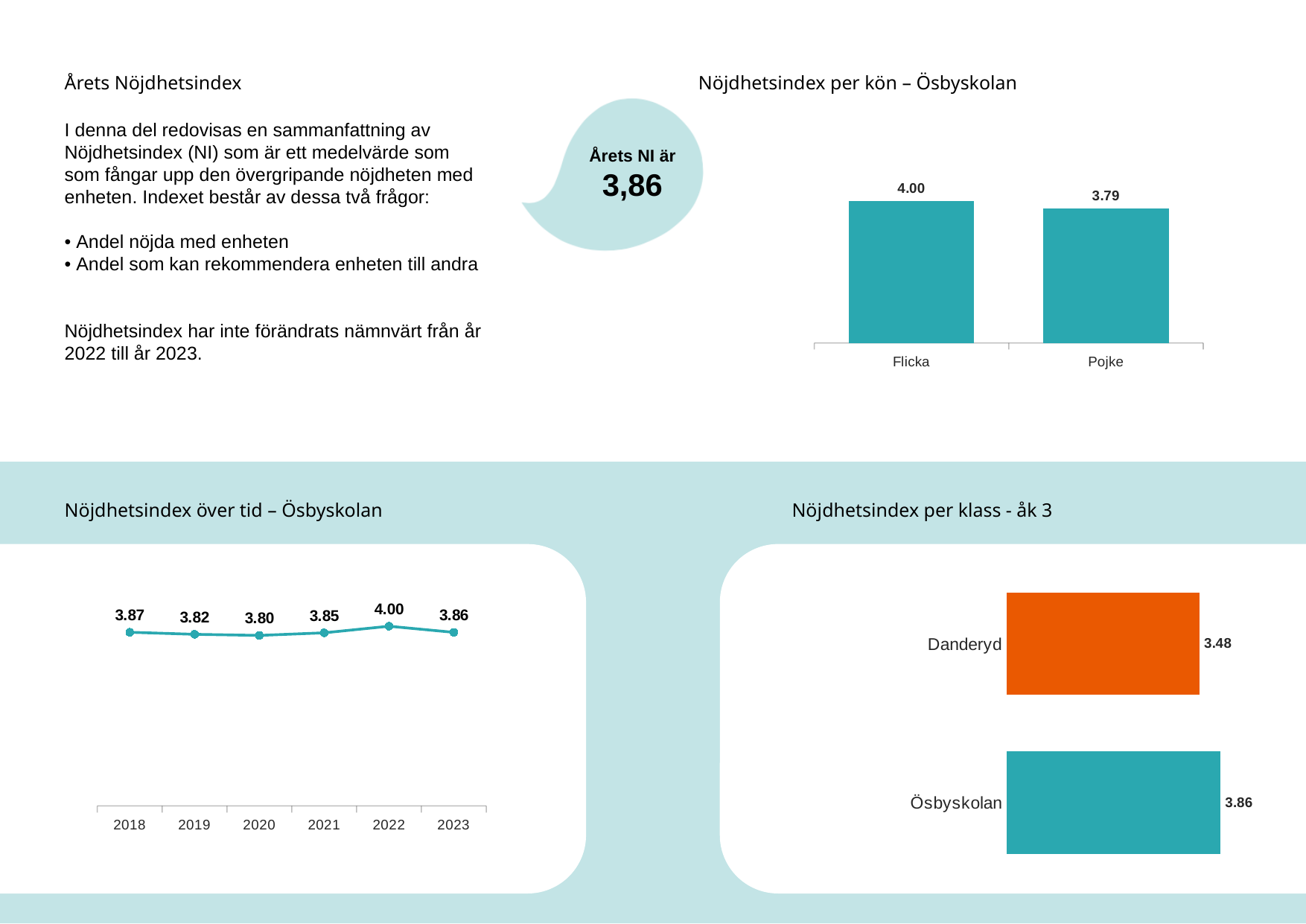
What kind of chart is 'Nöjdhetsindex per klass - åk 3'? Bar chart What kind of chart is 'Nöjdhetsindex över tid – Ösbyskolan'? Line chart In the 'Nöjdhetsindex över tid – Ösbyskolan' chart, which year has the lowest value? 2020 How many years are plotted in the 'Nöjdhetsindex över tid – Ösbyskolan' chart? 6 In the 'Nöjdhetsindex per kön – Ösbyskolan' chart, what is the value for Pojke? 3.79 In the 'Nöjdhetsindex per kön – Ösbyskolan' chart, what is the value for Flicka? 4.00 In the 'Nöjdhetsindex per klass - åk 3' chart, what is the value for Danderyd? 3.48 In the 'Nöjdhetsindex per kön – Ösbyskolan' chart, which category has the higher value, Flicka or Pojke? Flicka In the 'Nöjdhetsindex över tid – Ösbyskolan' chart, which year has the highest value? 2022 In the 'Nöjdhetsindex över tid – Ösbyskolan' chart, what is the value for 2020? 3.80 In the 'Nöjdhetsindex per klass - åk 3' chart, what is the difference between Ösbyskolan and Danderyd? 0.38 In the 'Nöjdhetsindex per kön – Ösbyskolan' chart, what is the difference between the values for Flicka and Pojke? 0.21